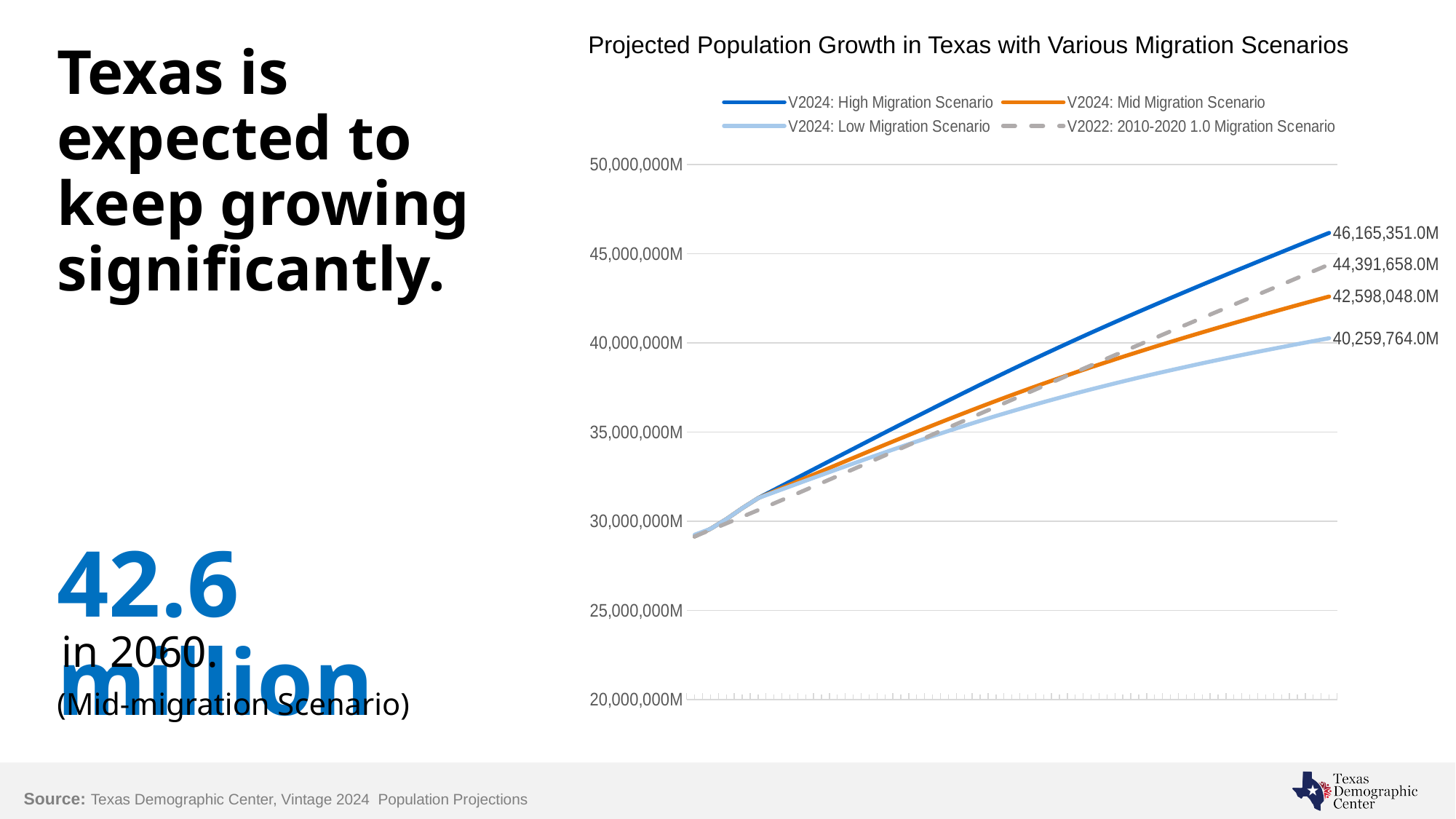
Do the projected population lines rise or fall along the x axis? rise Which ends higher, the V2022: 2010-2020 1.0 Migration Scenario line or the V2024: Mid Migration Scenario line? V2022: 2010-2020 1.0 Migration Scenario What is the final labelled value for the V2022: 2010-2020 1.0 Migration Scenario line? 44,391,658.0M How many series does the chart legend list? 4 What is the difference between the final values of the V2024: High Migration Scenario and the V2024: Mid Migration Scenario? 3,567,303.0M What is the final labelled value for the V2024: Low Migration Scenario line? 40,259,764.0M Which scenario ends with the lowest projected population? V2024: Low Migration Scenario What kind of chart is shown on the slide? line chart Is the final value for the V2024: Low Migration Scenario greater or less than 45,000,000M? less What is the final labelled value for the V2024: High Migration Scenario line? 46,165,351.0M What is the final labelled value for the V2024: Mid Migration Scenario line? 42,598,048.0M Which scenario ends with the highest projected population? V2024: High Migration Scenario